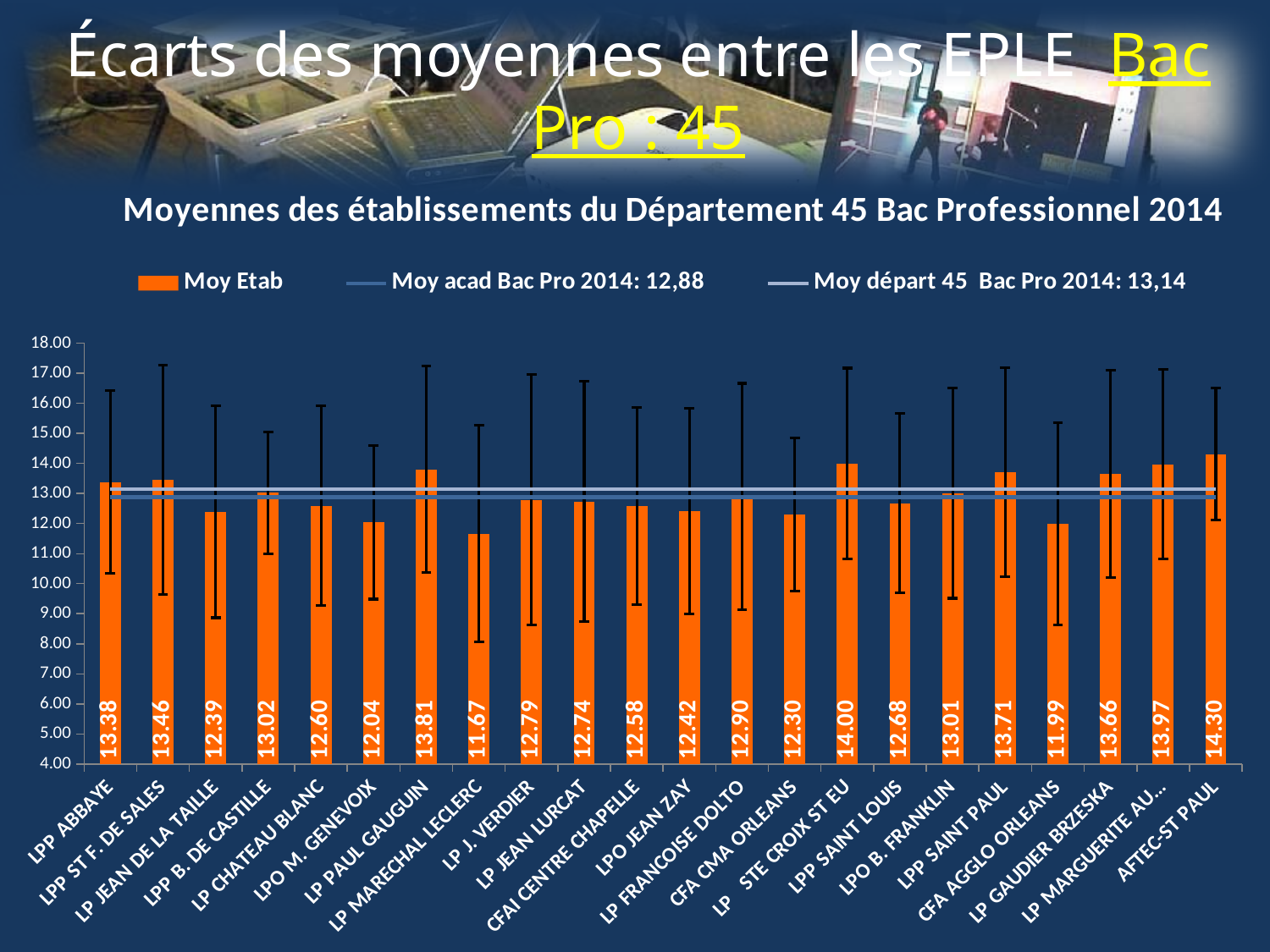
Which has a higher Moy Etab value, LPP ABBAYE or LP JEAN DE LA TAILLE? LPP ABBAYE How many series does the chart legend list? 3 What is the Moy Etab value for CFA CMA ORLEANS? 12.30 What is the Moy Etab value for LP PAUL GAUGUIN? 13.81 Which establishment has the highest Moy Etab value? AFTEC-ST PAUL Is the Moy Etab value for LP STE CROIX ST EU greater or less than 13.00? greater What kind of chart is used to show the Moy Etab values? Bar chart Which establishment has the lowest Moy Etab value? LP MARECHAL LECLERC What is the difference between the Moy Etab values of AFTEC-ST PAUL and LP MARECHAL LECLERC? 2.63 How many establishments are shown on the x axis of the chart? 22 What is the Moy Etab value for LPP ABBAYE? 13.38 According to the legend, what is the value of Moy départ 45 Bac Pro 2014? 13,14